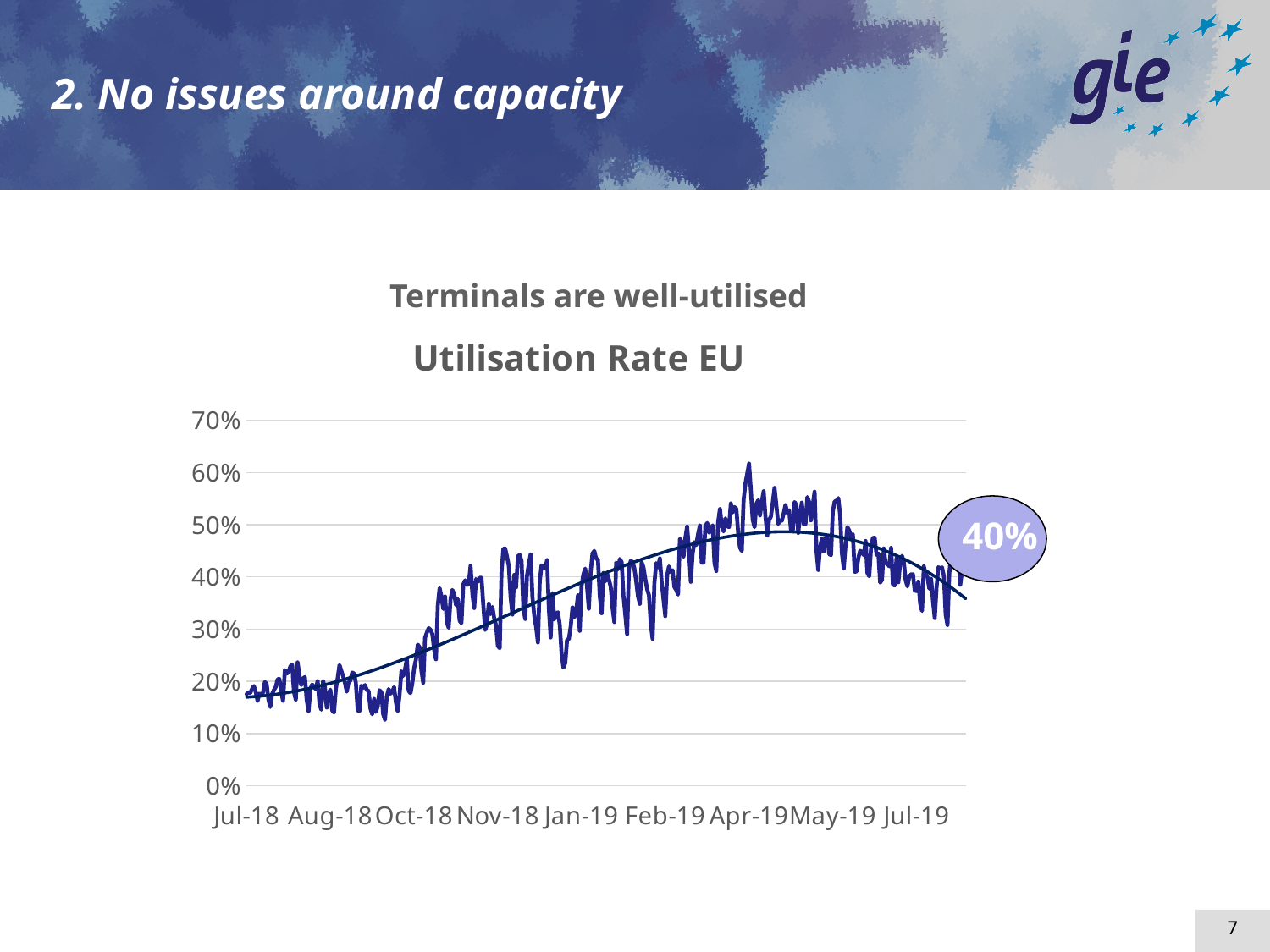
What is the title of the chart? Utilisation Rate EU Around which x-axis label does the utilisation rate reach its highest values? Apr-19 Is the utilisation rate around Apr-19 greater or less than 40%? greater Is the utilisation rate at Jul-18 greater or less than 30%? less Is the utilisation rate higher around Apr-19 or around Jul-18? Apr-19 What value is shown in the callout bubble at the right end of the line? 40% Does the utilisation rate rise or fall from Jul-18 to Apr-19? rise What is the highest tick value shown on the y axis? 70% How many date labels are shown on the x axis? 9 Does the utilisation rate rise or fall from Apr-19 to Jul-19? fall Is the utilisation rate at Jul-18 greater or less than 10%? greater What kind of chart is shown on the slide? line chart